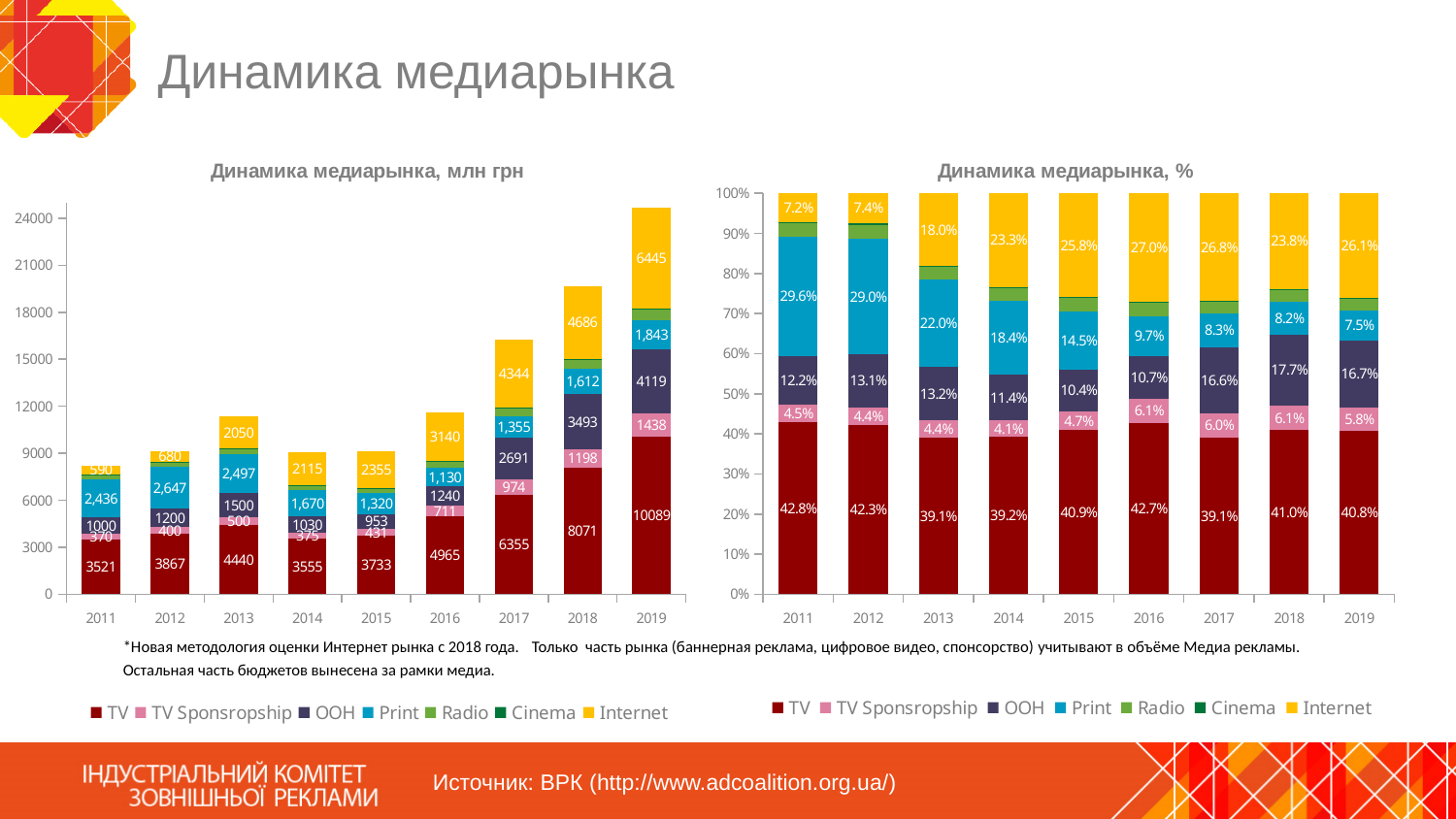
In the chart 'Динамика медиарынка, млн грн', what is the TV value for 2019? 10089 In the chart 'Динамика медиарынка, млн грн', which year has the highest TV value? 2019 How many years are shown on the x axis of the chart 'Динамика медиарынка, млн грн'? 9 In the chart 'Динамика медиарынка, млн грн', which year has the lowest Internet value? 2011 How many series does the legend of the chart 'Динамика медиарынка, %' list? 7 In the chart 'Динамика медиарынка, %', does the Print share rise or fall from 2011 to 2019? fall In the chart 'Динамика медиарынка, млн грн', what is the Print value for 2012? 2,647 In the chart 'Динамика медиарынка, %', what is the Print share for 2019? 7.5% In the chart 'Динамика медиарынка, %', what is the Internet share for 2016? 27.0% In the chart 'Динамика медиарынка, млн грн', which is larger in 2016: the OOH value or the Print value? OOH In the chart 'Динамика медиарынка, млн грн', what is the Internet value for 2017? 4344 In the chart 'Динамика медиарынка, млн грн', what is the difference between the TV values for 2019 and 2018? 2018